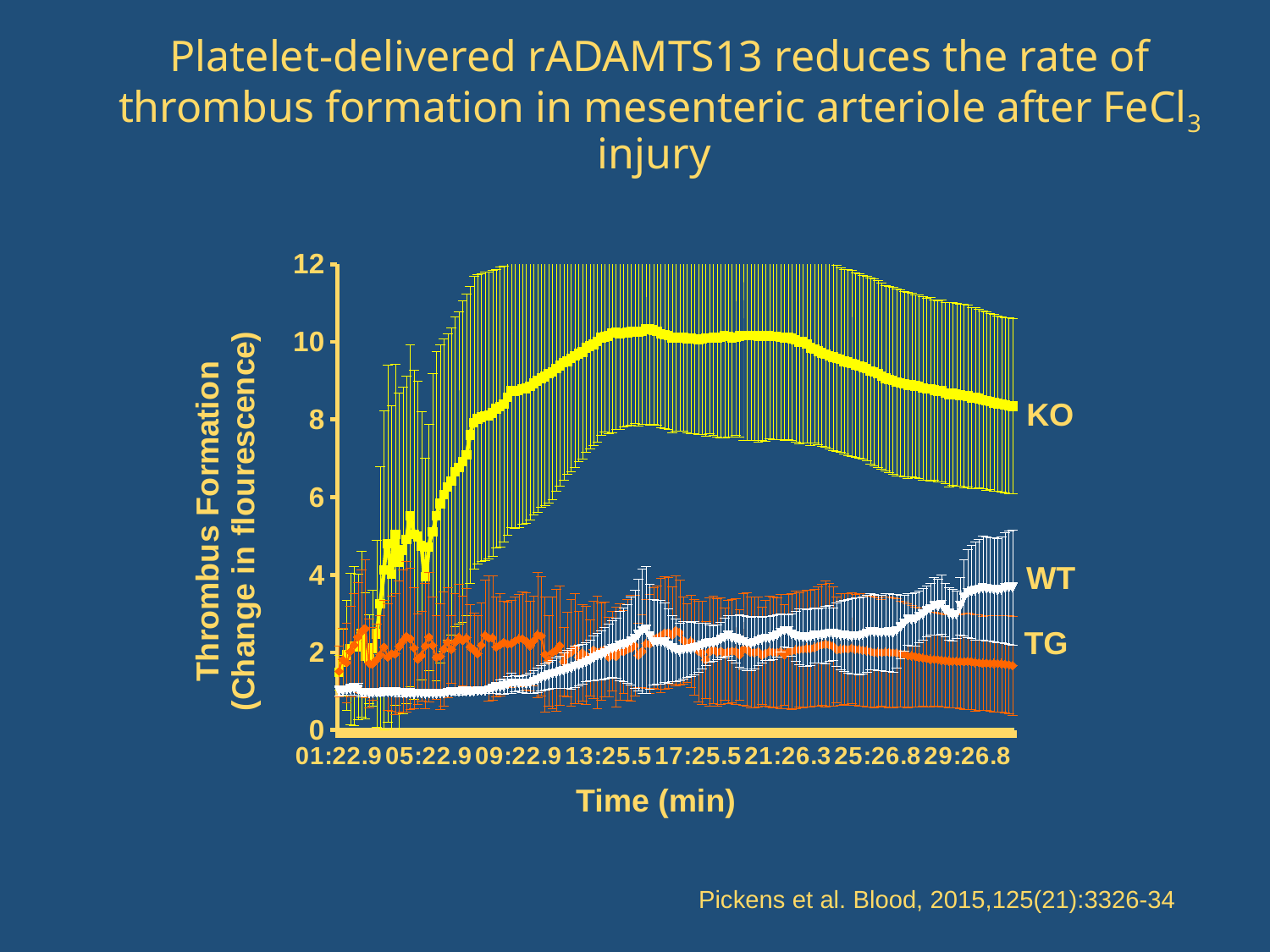
Which series has the lowest value at the last time point (29:26.8)? TG What is the title of the x axis? Time (min) How many series are plotted on the chart? 3 How many time labels are shown on the x axis? 8 At 29:26.8, which series has the larger value, WT or TG? WT What kind of chart is shown on the slide? line chart At 13:25.5, which series has the larger value, KO or WT? KO Is the value of the TG series at 29:26.8 greater or less than 4? less Does the KO series rise or fall between 01:22.9 and 13:25.5? rise Is the value of the WT series at 29:26.8 greater or less than 2? greater Which series reaches the highest thrombus formation values? KO Is the peak value of the KO series greater or less than 8? greater